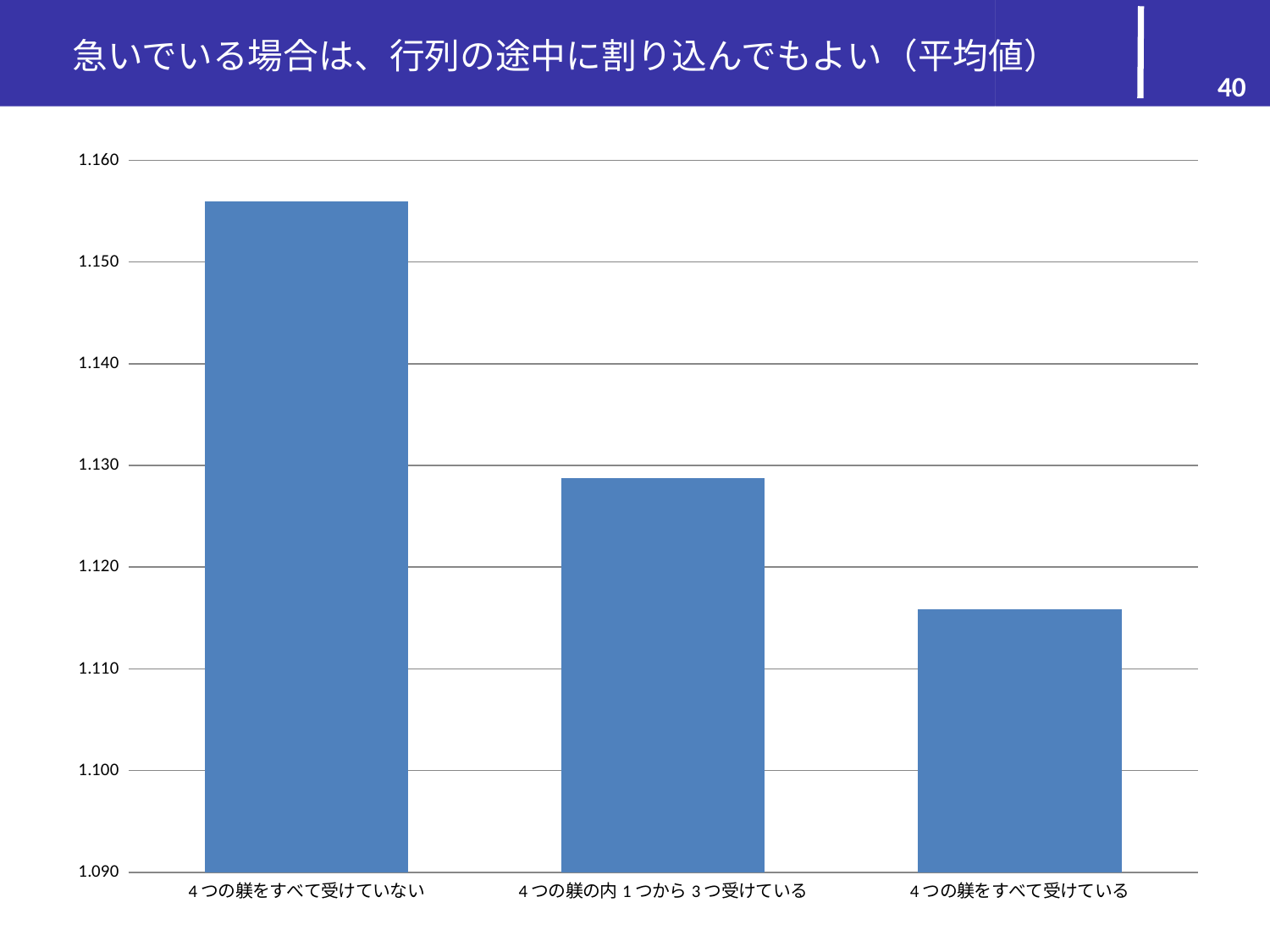
Do the values rise or fall from left to right across the categories? fall Is the value for 4つの躾をすべて受けている greater or less than 1.110? greater Which category has the lowest value? 4つの躾をすべて受けている Which is larger, the value for 4つの躾の内1つから3つ受けている or the value for 4つの躾をすべて受けている? 4つの躾の内1つから3つ受けている Is the value for 4つの躾をすべて受けていない greater or less than 1.150? greater What kind of chart is shown on the slide? bar chart Which is larger, the value for 4つの躾をすべて受けていない or the value for 4つの躾の内1つから3つ受けている? 4つの躾をすべて受けていない Which category has the highest value? 4つの躾をすべて受けていない Is the value for 4つの躾をすべて受けている greater or less than 1.120? less How many categories are plotted in the chart? 3 What is the title of the slide? 急いでいる場合は、行列の途中に割り込んでもよい（平均値）